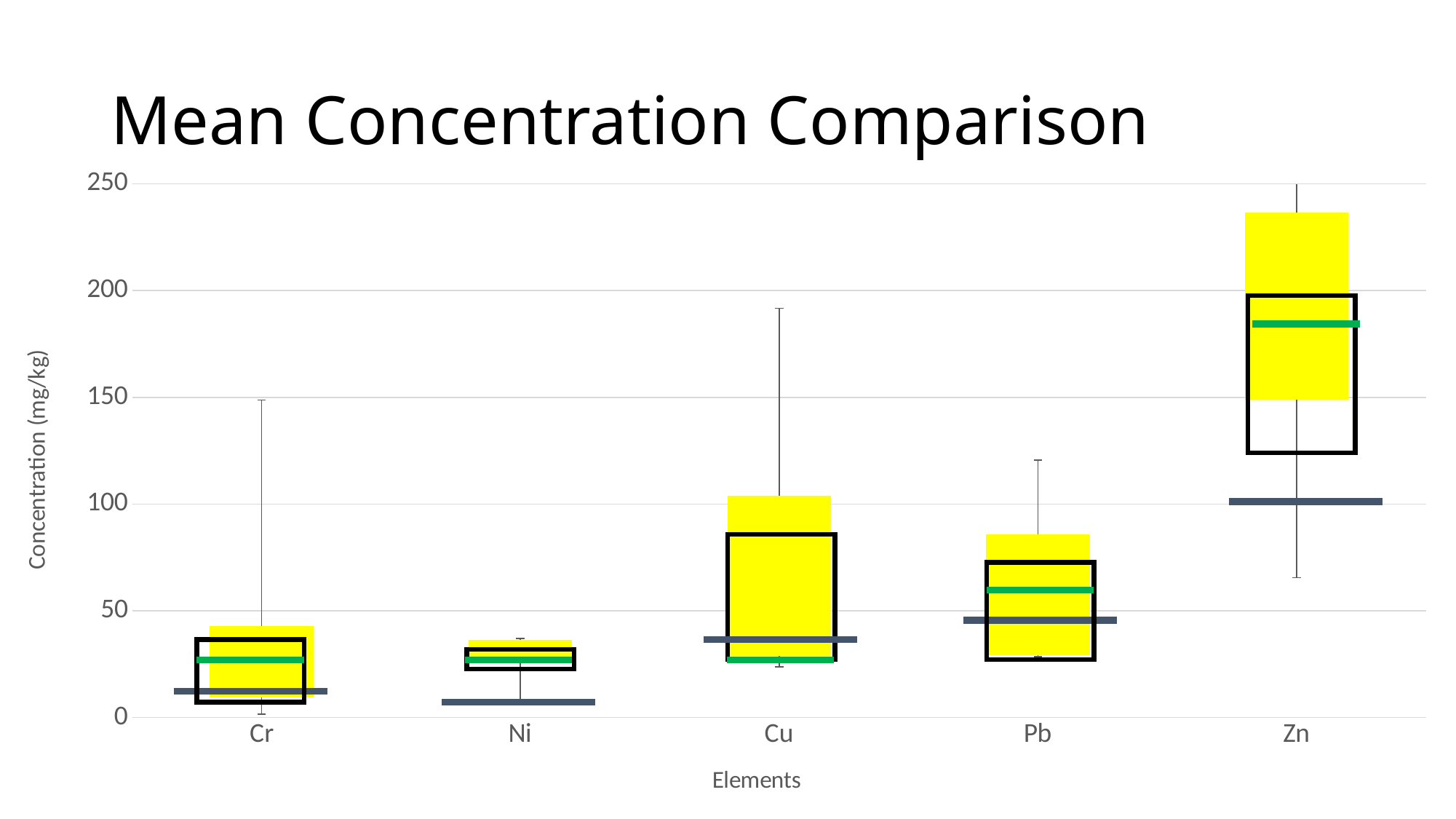
What is the label of the y axis? Concentration (mg/kg) What is the title of the chart? Mean Concentration Comparison Which element has a higher yellow box top, Pb or Ni? Pb Is the top of the upper whisker for Pb greater or less than 100? greater Is the top of the yellow box for Zn greater or less than 200? greater Which element has the highest concentration values on the chart? Zn What kind of chart is shown on the slide? Box-and-whisker plot Is the top of the yellow box for Ni greater or less than 50? less How many elements are shown along the x axis? 5 Which element has a higher yellow box top, Zn or Cu? Zn